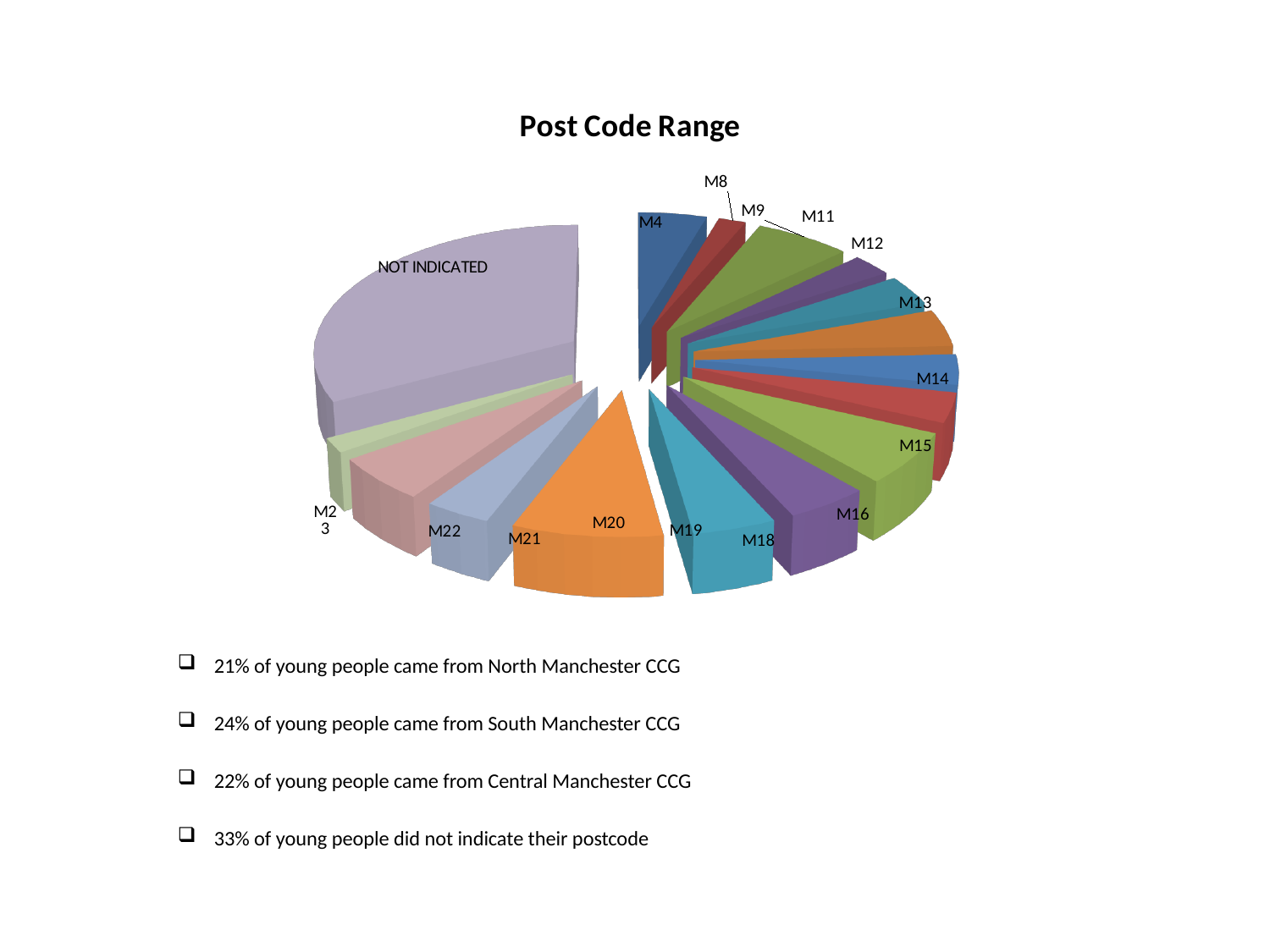
Which slice is larger, M20 or M8? M20 What kind of chart is shown on the slide? pie chart Which slice is larger, M15 or M9? M9 Which slice is larger, NOT INDICATED or M20? NOT INDICATED How many slices does the pie chart have? 16 Which slice of the pie chart is the largest? NOT INDICATED What is the title of the chart? Post Code Range Does the pie chart include a legend? No